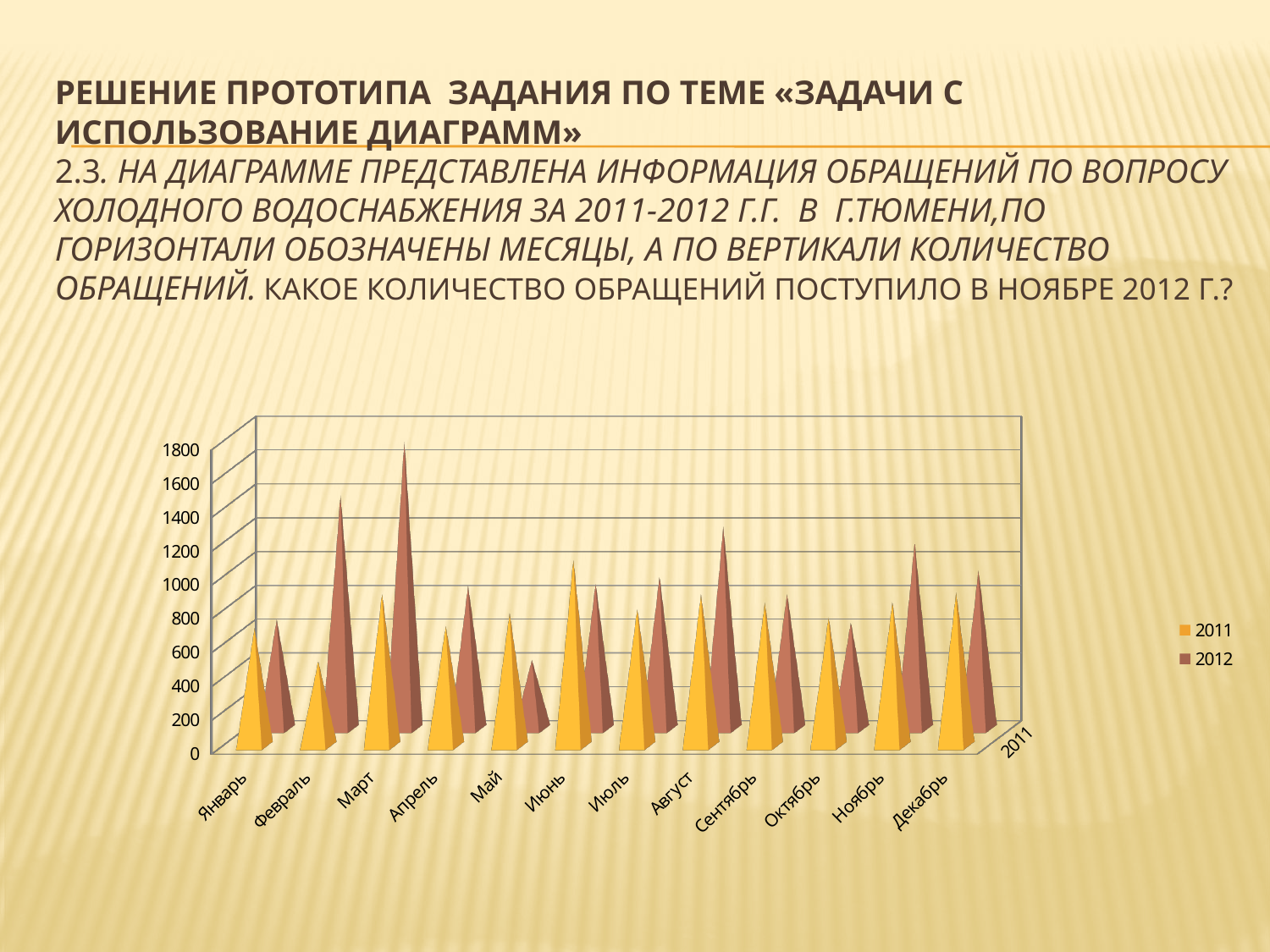
How many series does the legend list? 2 What are the two entries listed in the legend? 2011 and 2012 Which month has the lowest value for the 2012 series? Май What kind of chart is shown on the slide? bar chart Which month has the lowest value for the 2011 series? Февраль Is the value for Март in the 2012 series greater or less than 1400? greater Is the value for Февраль in the 2011 series greater or less than 800? less Is the value for Май in the 2012 series greater or less than 800? less Which month has the highest value for the 2011 series? Июнь For Март, which series has the larger value, 2011 or 2012? 2012 Which month has the highest value for the 2012 series? Март How many months (categories) are shown along the horizontal axis? 12